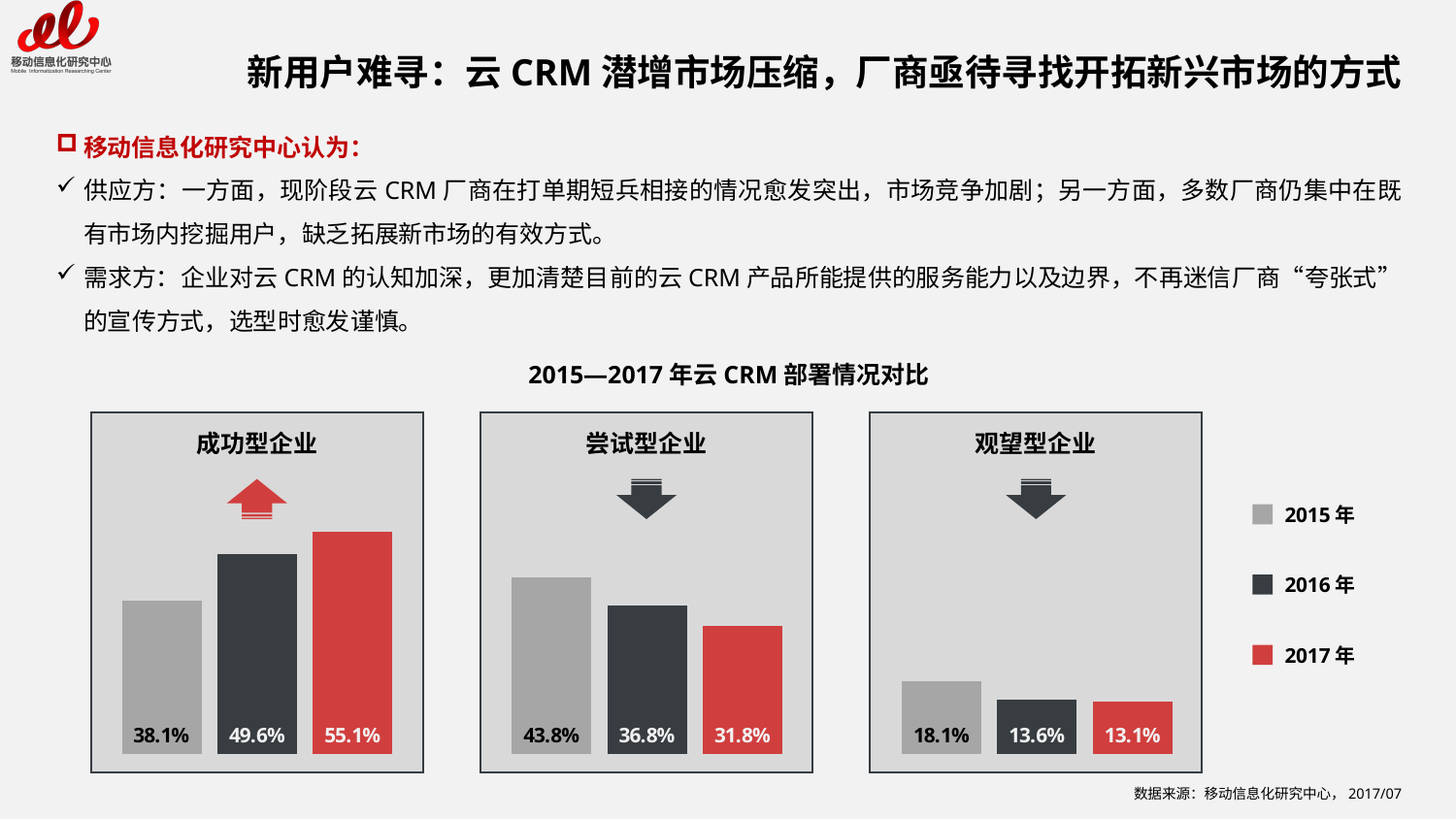
What kind of chart is used for 尝试型企业? bar chart How many series does the legend list for the charts? 3 In the 成功型企业 chart, which year has the lowest value? 2015 年 In the 尝试型企业 chart, what is the value for 2015 年? 43.8% In the 观望型企业 chart, do the values rise or fall from 2015 年 to 2017 年? fall In the 观望型企业 chart, what is the value for 2016 年? 13.6% In the 尝试型企业 chart, which is larger, the value for 2016 年 or 2017 年? 2016 年 In the 成功型企业 chart, what is the difference between the 2017 年 and 2015 年 values? 17.0% In the 成功型企业 chart, do the values rise or fall from 2015 年 to 2017 年? rise In the 观望型企业 chart, what is the difference between the 2015 年 and 2017 年 values? 5.0% In the 成功型企业 chart, what is the value for 2017 年? 55.1% In the 尝试型企业 chart, which year has the highest value? 2015 年